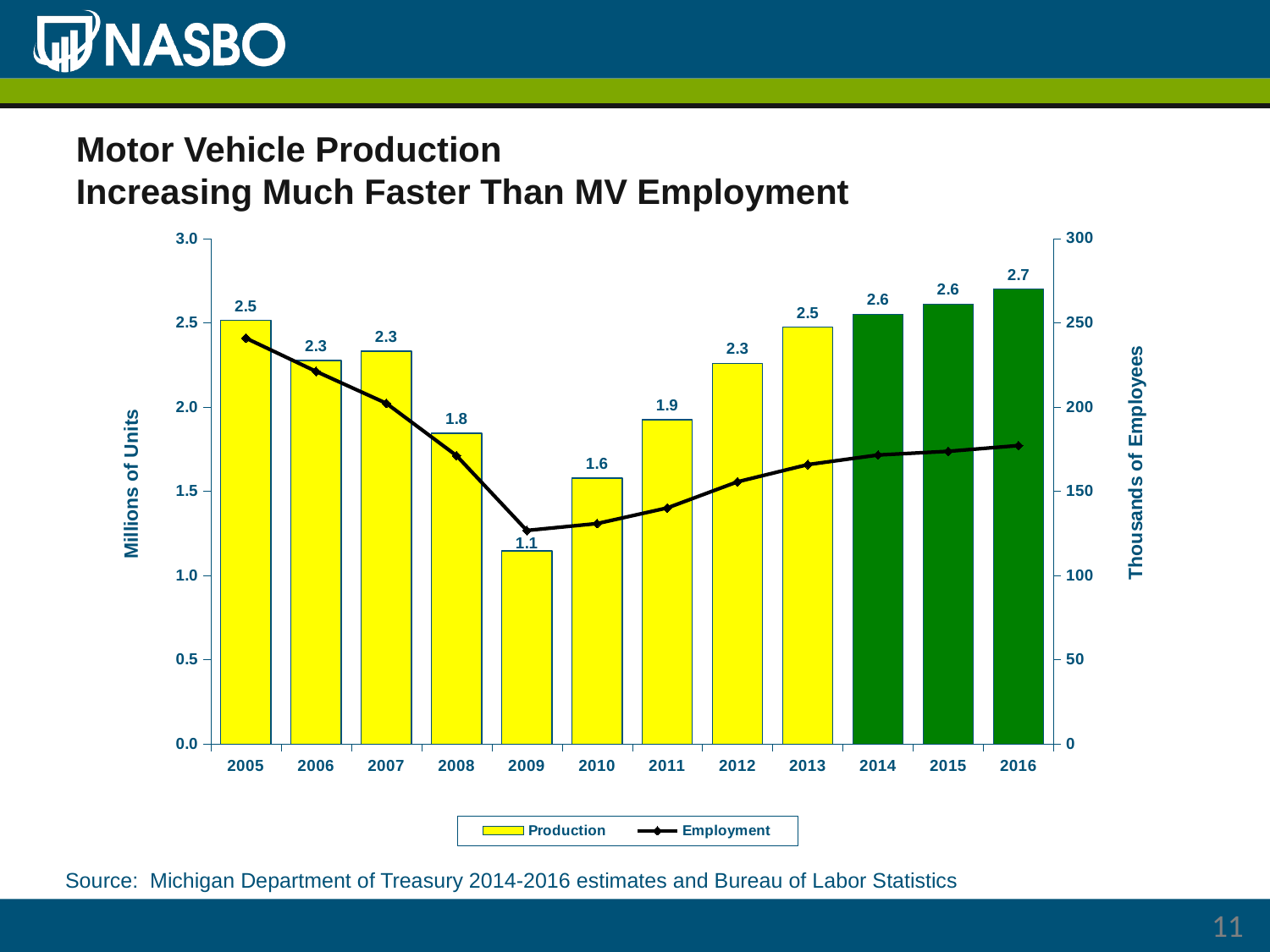
What is the difference between the production values for 2016 and 2009, in millions of units? 1.6 How many years are shown on the x axis of the chart? 12 What was motor vehicle production in 2009, in millions of units? 1.1 Which year has the lowest production value? 2009 Which year has the highest production value? 2016 How many series does the chart legend list? 2 Is the Employment value for 2009 greater or less than 150 thousand employees? less What is the production value shown for 2008? 1.8 What is the production value shown for 2016? 2.7 Does the Employment line rise or fall from 2005 to 2009? fall Which year has the larger production value, 2008 or 2010? 2008 Is the Employment value for 2005 greater or less than 200 thousand employees? greater